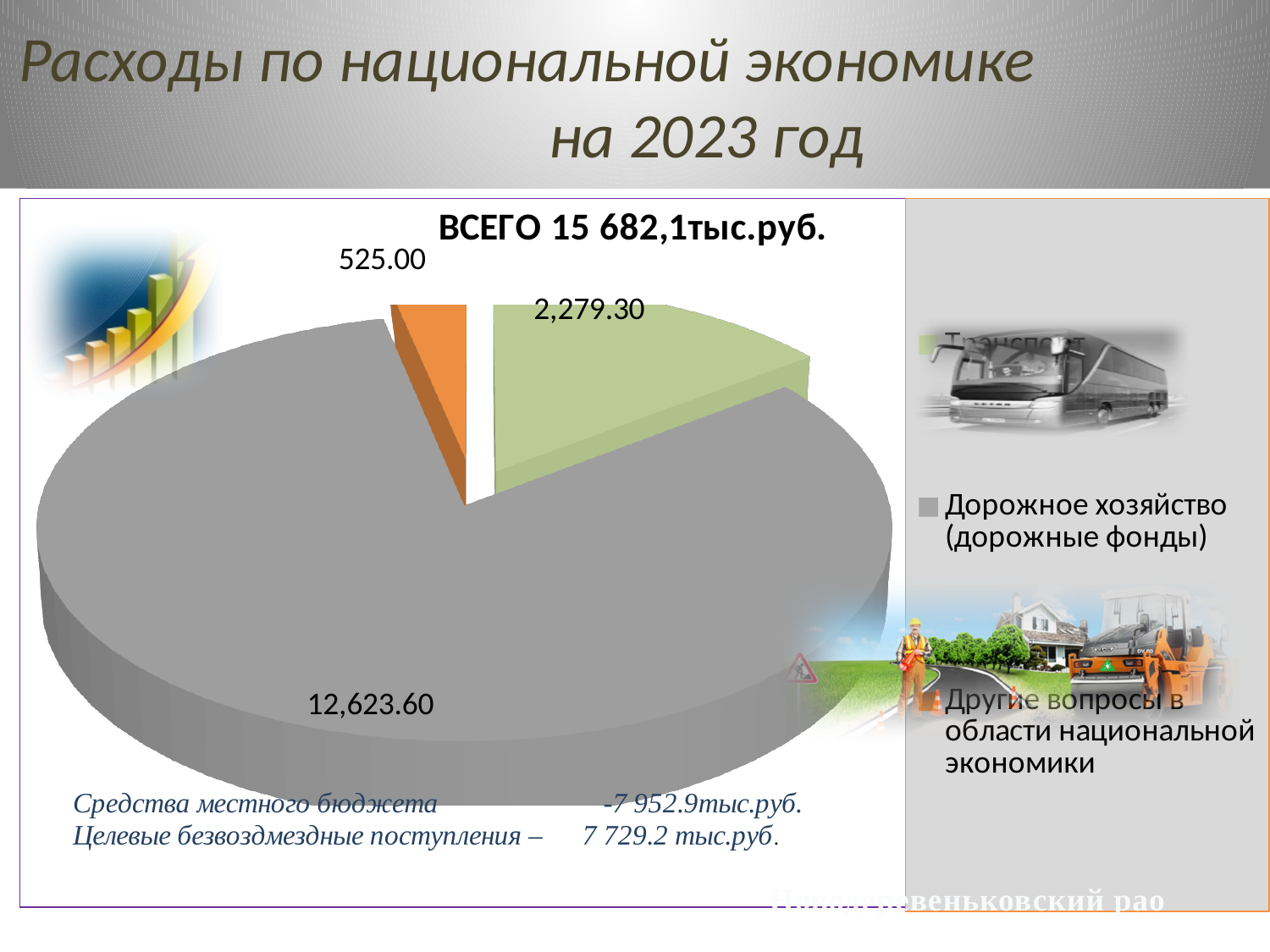
Which category has the largest slice in the pie chart? Дорожное хозяйство (дорожные фонды) What is the value shown on the green slice of the pie chart? 2,279.30 What is the difference between the green slice (2,279.30) and the slice for Другие вопросы в области национальной экономики? 1,754.30 How many entries does the legend list? 3 Which category has the smallest slice in the pie chart? Другие вопросы в области национальной экономики Which is larger: the green slice or the slice for Другие вопросы в области национальной экономики? the green slice What is the value of the slice for Дорожное хозяйство (дорожные фонды)? 12,623.60 What total amount is stated in the chart title? ВСЕГО 15 682,1тыс.руб. What kind of chart is shown on the slide? pie chart What is the difference between the value for Дорожное хозяйство (дорожные фонды) and the value of the green slice (2,279.30)? 10,344.30 What is the value of the slice for Другие вопросы в области национальной экономики? 525.00 How many slices does the pie chart have? 3